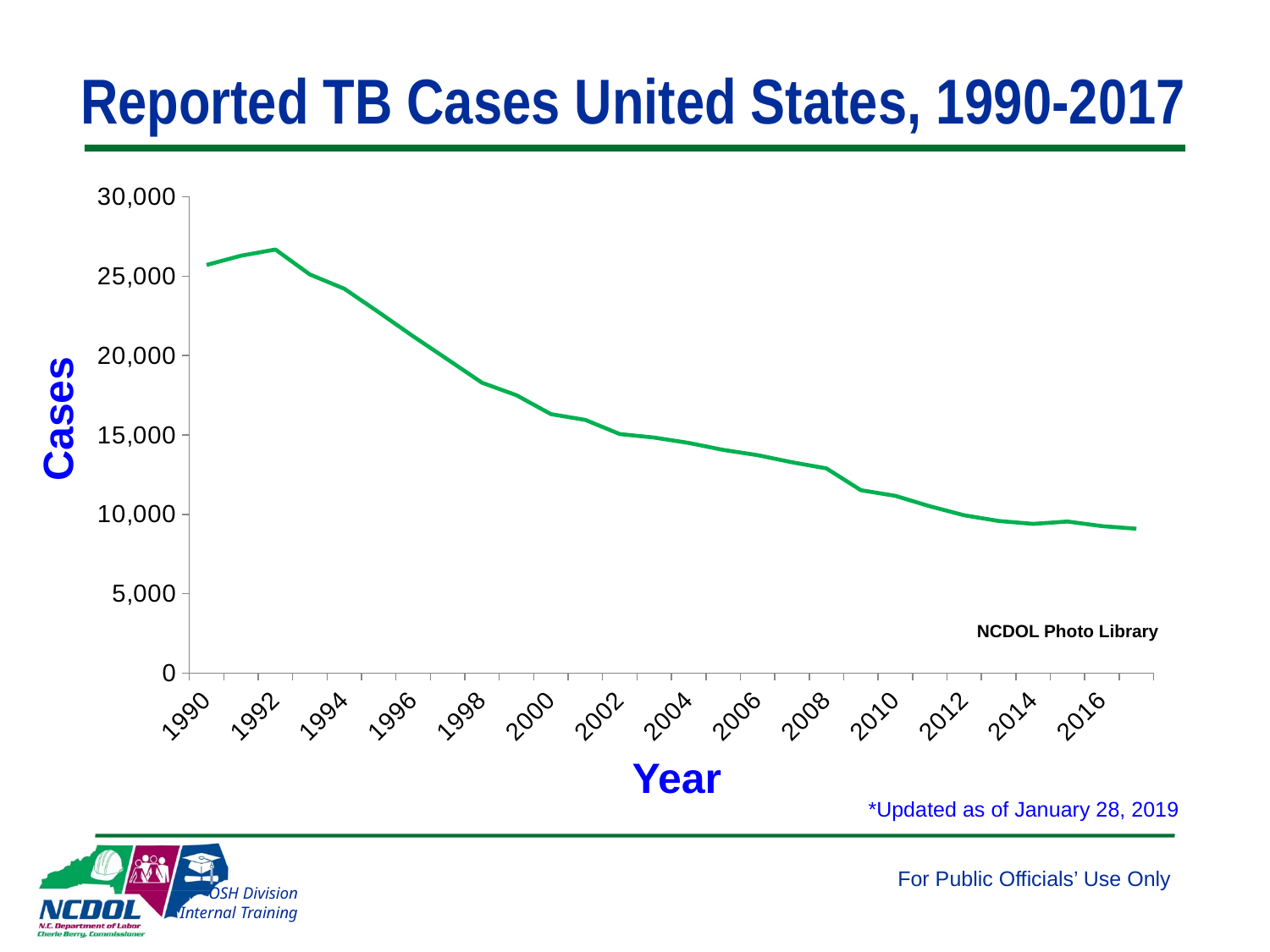
Do reported TB cases generally rise or fall from 1992 to 2017? fall What kind of chart is shown on the slide? line chart Which year has the highest number of reported TB cases? 1992 Is the value for 2008 greater or less than 15,000? less Is the value for 2000 greater or less than 15,000? greater What is the label on the vertical axis? Cases Which year has more reported TB cases, 1990 or 2017? 1990 Is the value for 1996 greater or less than 20,000? greater Which year has the lowest number of reported TB cases? 2017 How many years of data are plotted on the chart? 28